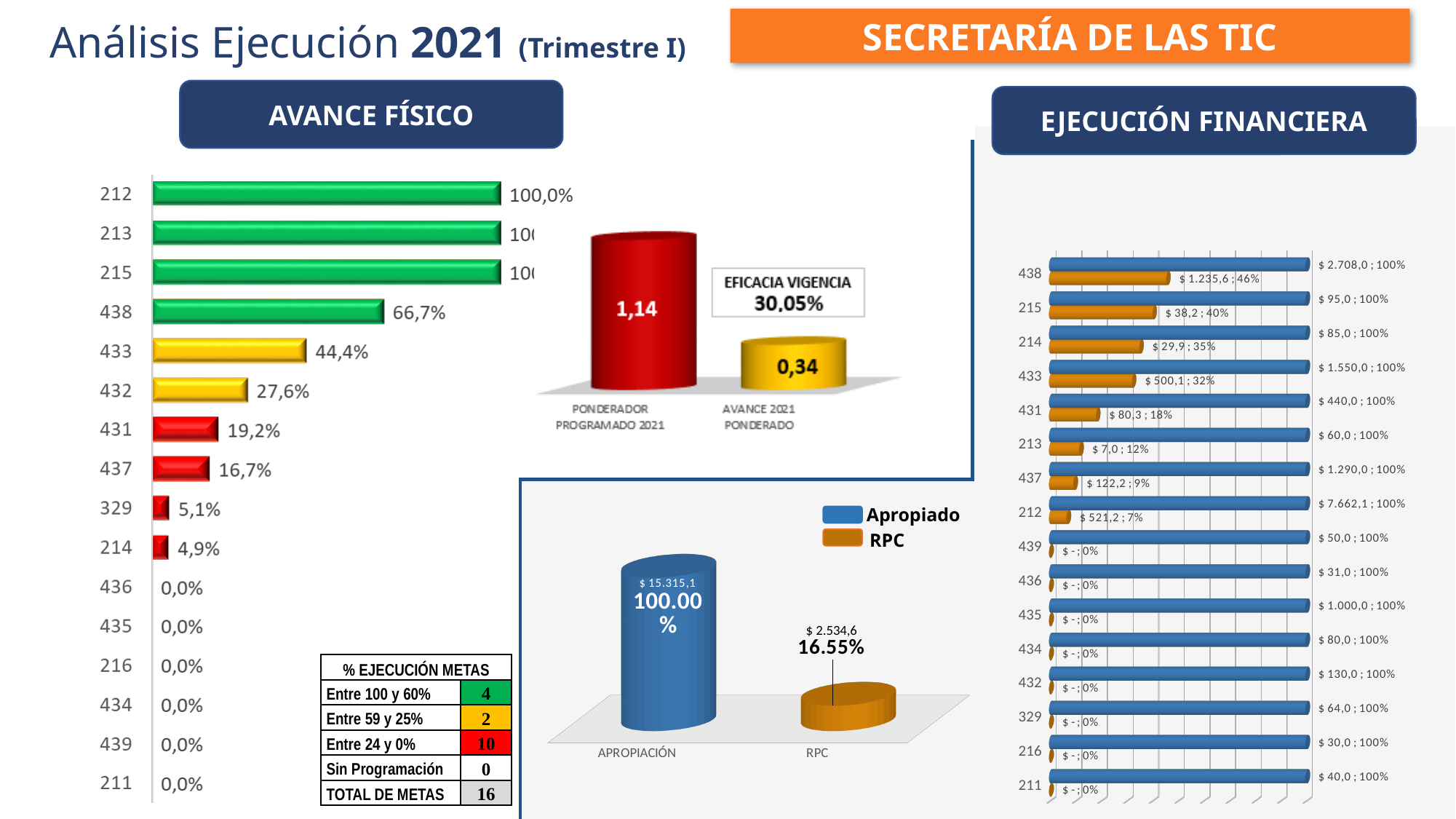
In the chart with Ponderador Programado 2021 and Avance 2021 Ponderado, which of the two values is larger? Ponderador Programado 2021 In the chart with Ponderador Programado 2021 and Avance 2021 Ponderado, what is the value for Ponderador Programado 2021? 1,14 In the Ejecución Financiera chart on the right, how many series does the legend list? 2 In the Avance Físico bar chart on the left, what is the value for category 432? 27,6% In the Apropiación/RPC chart at the bottom centre, what amount is shown for Apropiación? $ 15.315,1 In the Avance Físico bar chart on the left, how many categories are plotted? 16 In the Avance Físico bar chart on the left, what is the value for category 438? 66,7% In the Avance Físico bar chart on the left, which of categories 329 and 214 has the larger value? 329 In the Avance Físico bar chart on the left, what is the difference between the values for 433 and 431? 25,2% In the Ejecución Financiera chart on the right, what is the RPC value for category 433? $ 500,1 ; 32% In the Apropiación/RPC chart at the bottom centre, what percentage is shown for RPC? 16.55% In the Ejecución Financiera chart on the right, which category has the highest Apropiado value? 212